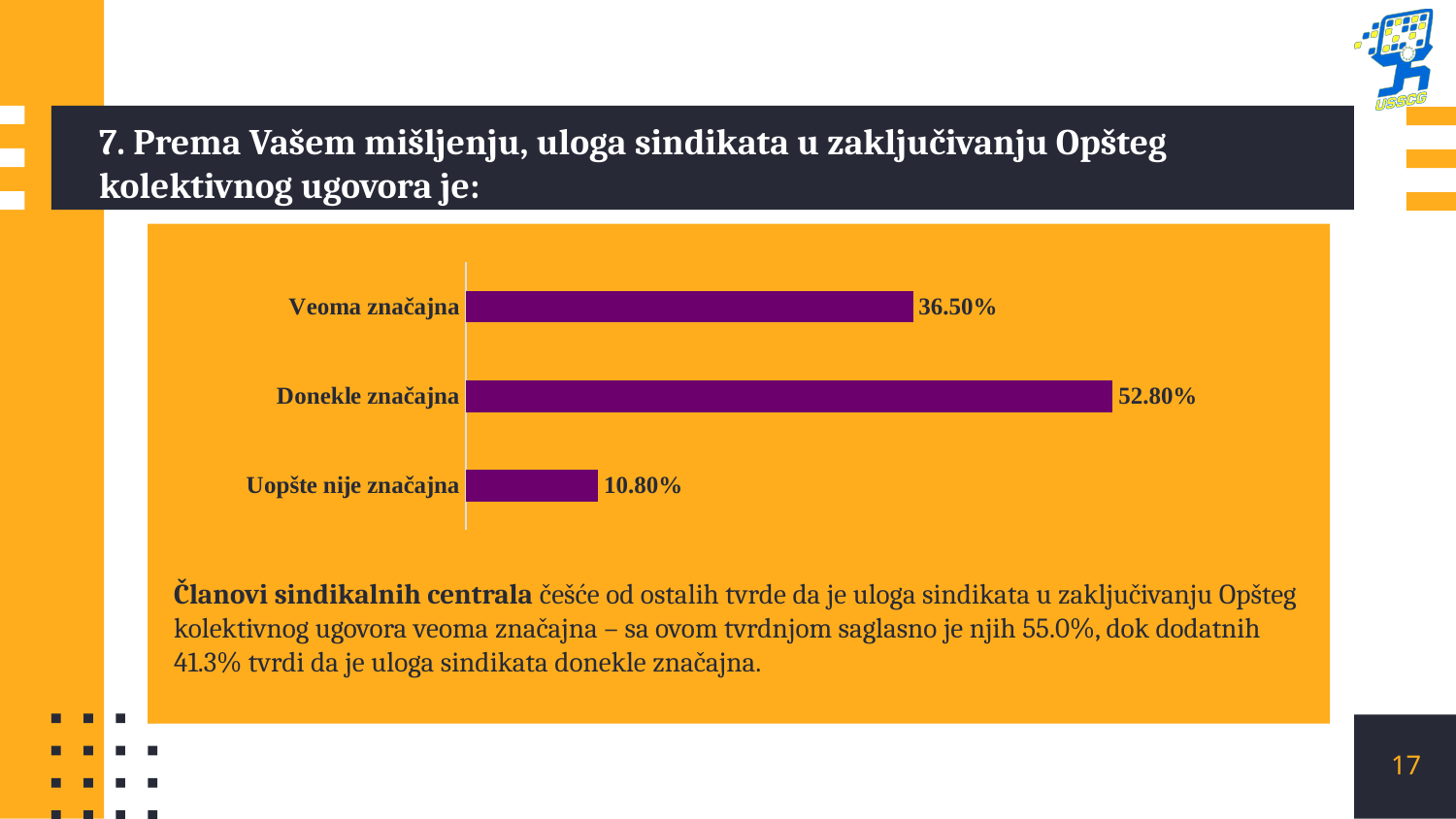
What is the value for "Uopšte nije značajna"? 10.80% How many categories are shown in the chart? 3 Which category has the lowest value? Uopšte nije značajna What is the value for "Veoma značajna"? 36.50% What is the difference between the values for "Veoma značajna" and "Uopšte nije značajna"? 25.70% Which category has the highest value? Donekle značajna What kind of chart is shown on the slide? Bar chart What is the value for "Donekle značajna"? 52.80% What colour are the bars in the chart? Purple What is the difference between the values for "Donekle značajna" and "Veoma značajna"? 16.30% What is the total of the three values shown in the chart? 100.10% Which is larger, the value for "Veoma značajna" or the value for "Uopšte nije značajna"? Veoma značajna